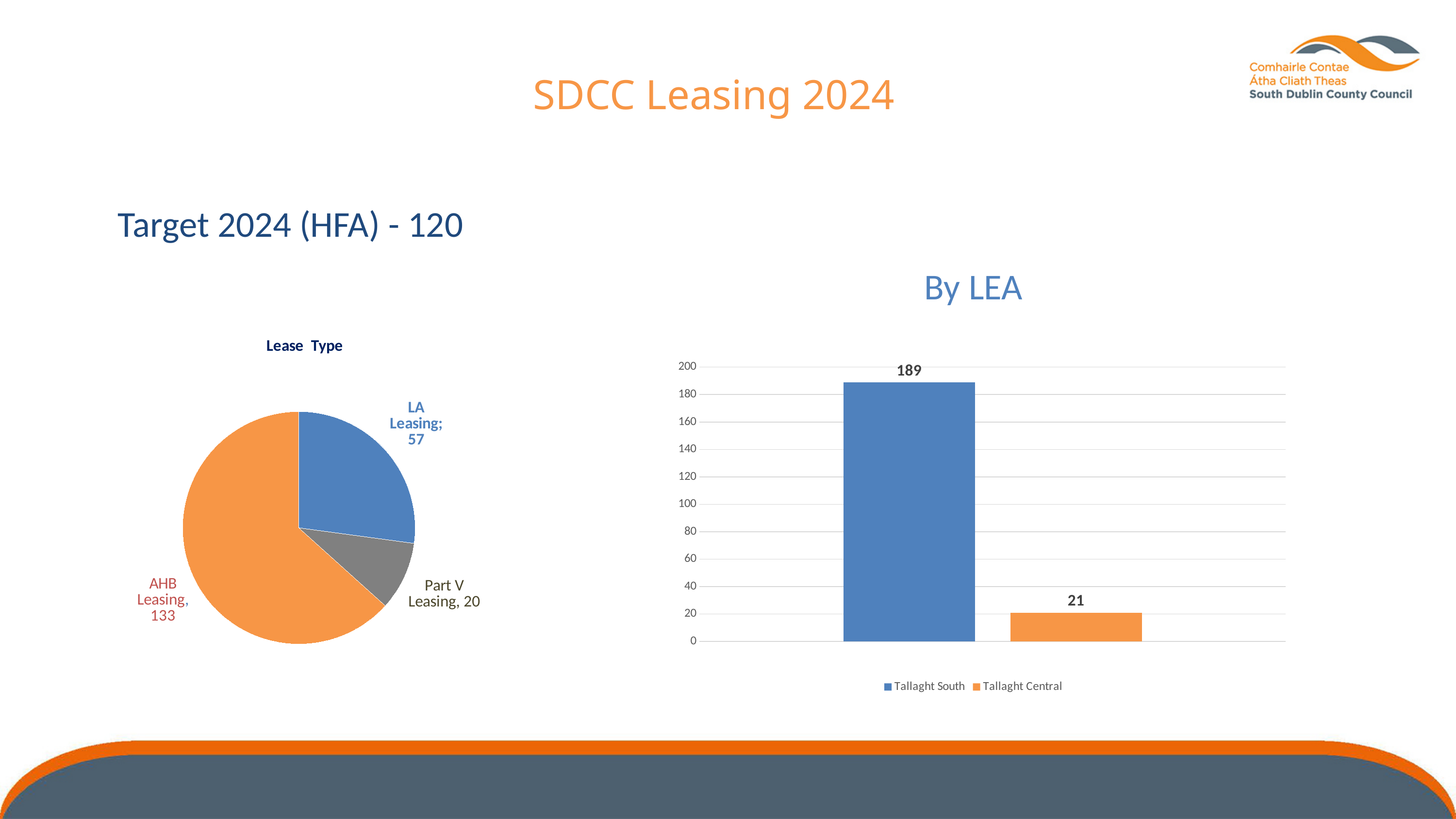
What kind of chart is the By LEA chart? Bar chart In the By LEA chart, what is the value for Tallaght South? 189 In the Lease Type pie chart, how many slices are there? 3 In the Lease Type pie chart, which lease type has the largest slice? AHB Leasing In the By LEA chart, what is the difference between Tallaght South and Tallaght Central? 168 In the Lease Type pie chart, which lease type has the smallest slice? Part V Leasing In the By LEA chart, what is the value for Tallaght Central? 21 In the By LEA chart, how many entries does the legend list? 2 In the Lease Type pie chart, what is the difference between AHB Leasing and LA Leasing? 76 In the Lease Type pie chart, what is the value for Part V Leasing? 20 In the Lease Type pie chart, what is the value for LA Leasing? 57 What kind of chart is the Lease Type chart? Pie chart